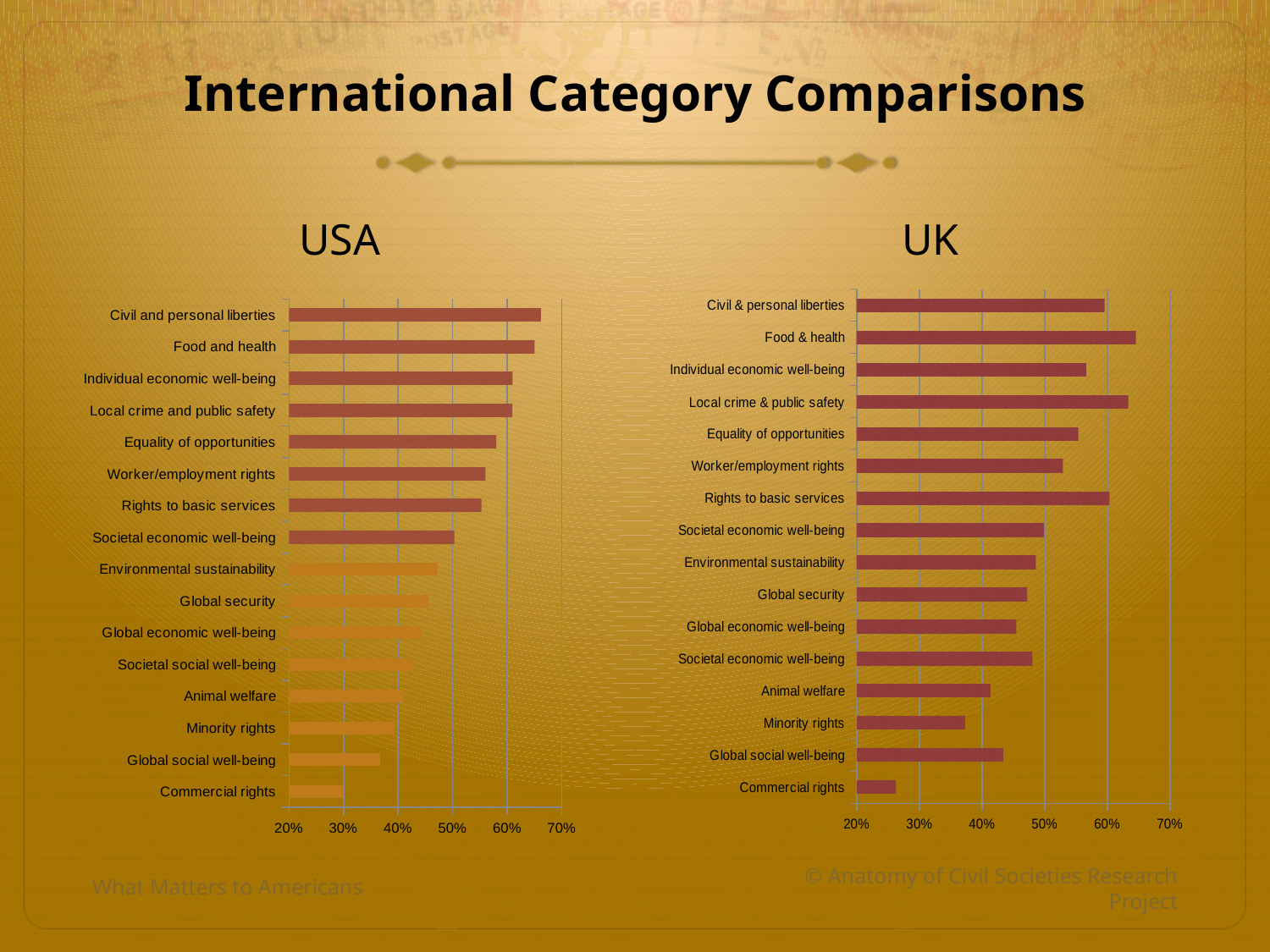
In the UK chart, is the value for Rights to basic services greater or less than 50%? greater How many categories does the UK chart show? 16 In the USA chart, which category has the lowest value? Commercial rights In the USA chart, which category has the highest value? Civil and personal liberties In the USA chart, is the value for Commercial rights greater or less than 40%? less In the UK chart, is the value for Minority rights greater or less than 40%? less In the USA chart, which is larger, Food and health or Equality of opportunities? Food and health In the UK chart, which category has the lowest value? Commercial rights What kind of chart is the USA chart? bar chart In the UK chart, which category has the highest value? Food & health What is the title of the slide? International Category Comparisons In the UK chart, which is larger, Local crime & public safety or Civil & personal liberties? Local crime & public safety